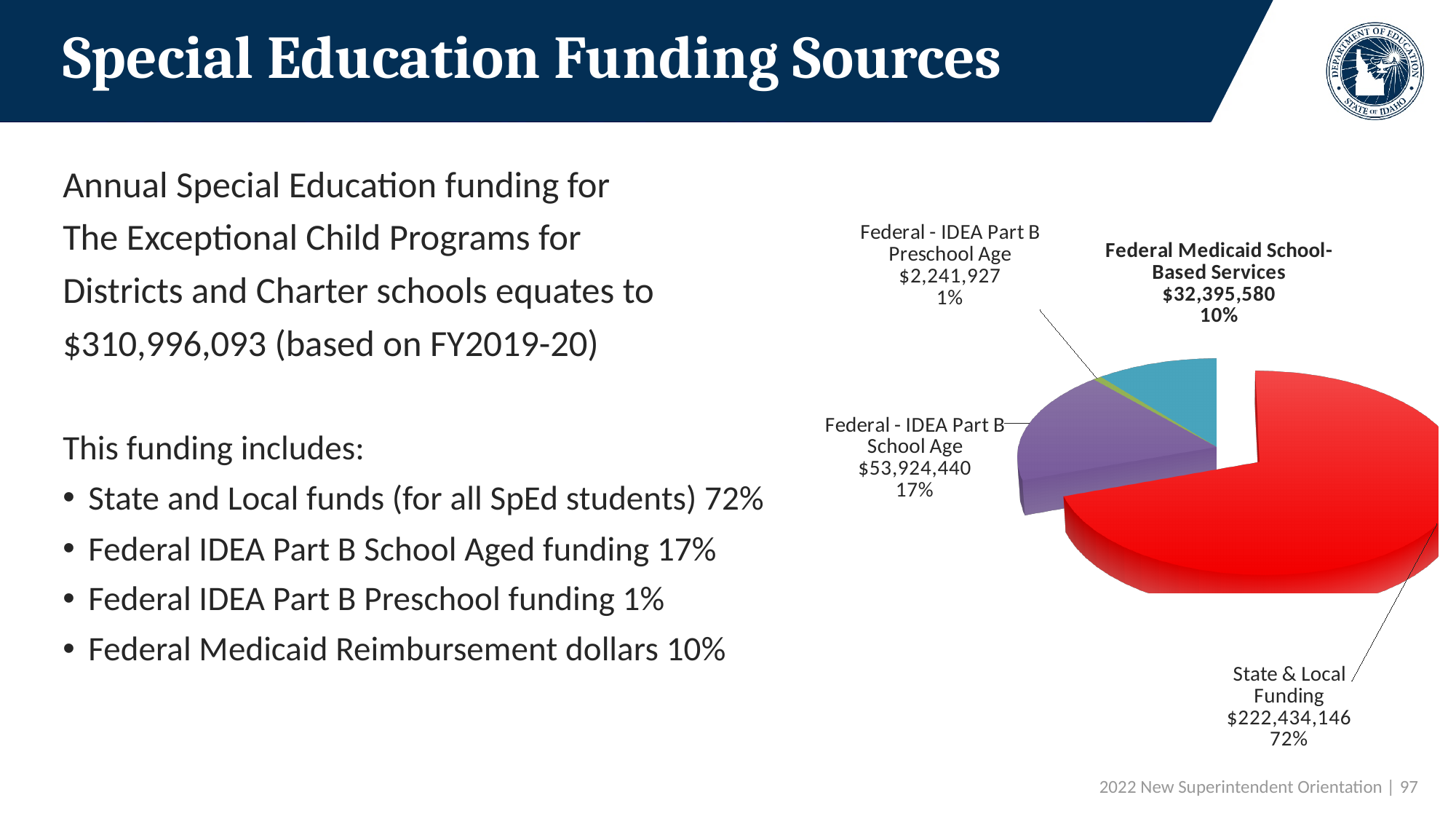
What is the dollar value of the Federal Medicaid School-Based Services slice? $32,395,580 What share of the pie does Federal - IDEA Part B School Age represent? 17% Which is larger, Federal Medicaid School-Based Services or Federal - IDEA Part B Preschool Age? Federal Medicaid School-Based Services What kind of chart is shown on the slide? pie chart What is the dollar value of the Federal - IDEA Part B Preschool Age slice? $2,241,927 Which slice of the pie chart is the largest? State & Local Funding What is the dollar value of the Federal - IDEA Part B School Age slice? $53,924,440 Which slice of the pie chart is the smallest? Federal - IDEA Part B Preschool Age What is the dollar value of the State & Local Funding slice? $222,434,146 What share of the pie does Federal Medicaid School-Based Services represent? 10% How many slices does the pie chart have? 4 What is the difference in dollars between Federal - IDEA Part B School Age and Federal Medicaid School-Based Services? $21,528,860